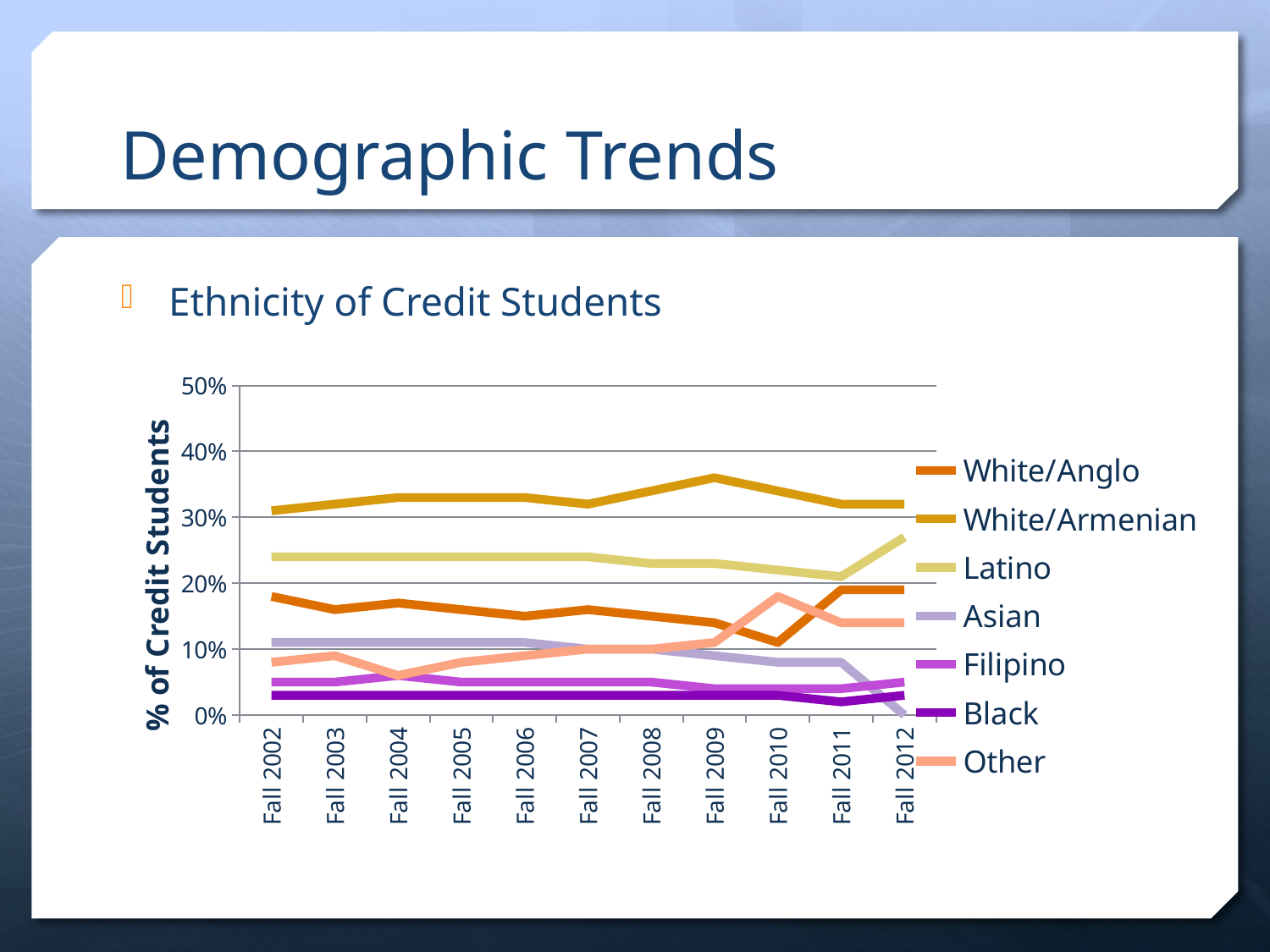
Is the value for White/Armenian in Fall 2009 greater or less than 30%? greater Does the Asian series rise or fall from Fall 2009 to Fall 2012? fall Is the value for Other in Fall 2010 greater or less than 10%? greater In Fall 2010, which is larger: Other or White/Anglo? Other Which series has the highest value in Fall 2009? White/Armenian Is the value for White/Anglo in Fall 2010 greater or less than 20%? less Which series has the lowest value in Fall 2002? Black How many time points are shown along the x axis? 11 What is the title of the y axis? % of Credit Students What kind of chart is shown on the slide? line chart In Fall 2012, which is larger: Latino or White/Anglo? Latino How many series does the legend list? 7